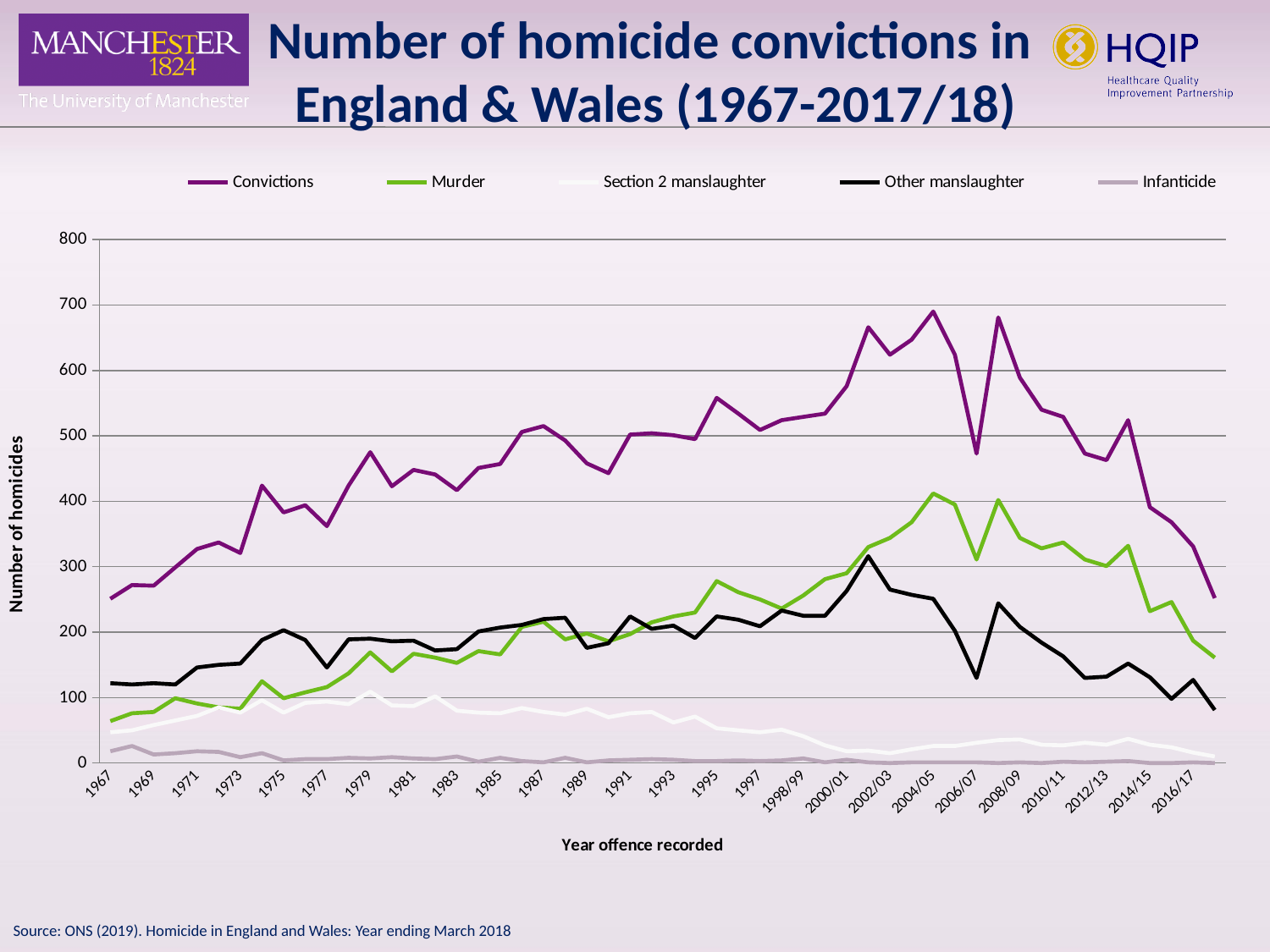
Is the value for Murder in 1967 greater or less than 100? less In 1967, which is larger: Murder or Other manslaughter? Other manslaughter What is the label on the vertical axis? Number of homicides Which series has the lowest values across the whole chart? Infanticide Is the value for Other manslaughter in 2016/17 greater or less than 100? greater Does the Murder line rise or fall between 2014/15 and 2016/17? Fall Is the value for Convictions in 1967 greater or less than 200? greater What kind of chart is shown on the slide? Line chart Which series has the highest values across the whole chart? Convictions How many series does the legend list? 5 What is the title of the chart? Number of homicide convictions in England & Wales (1967-2017/18)